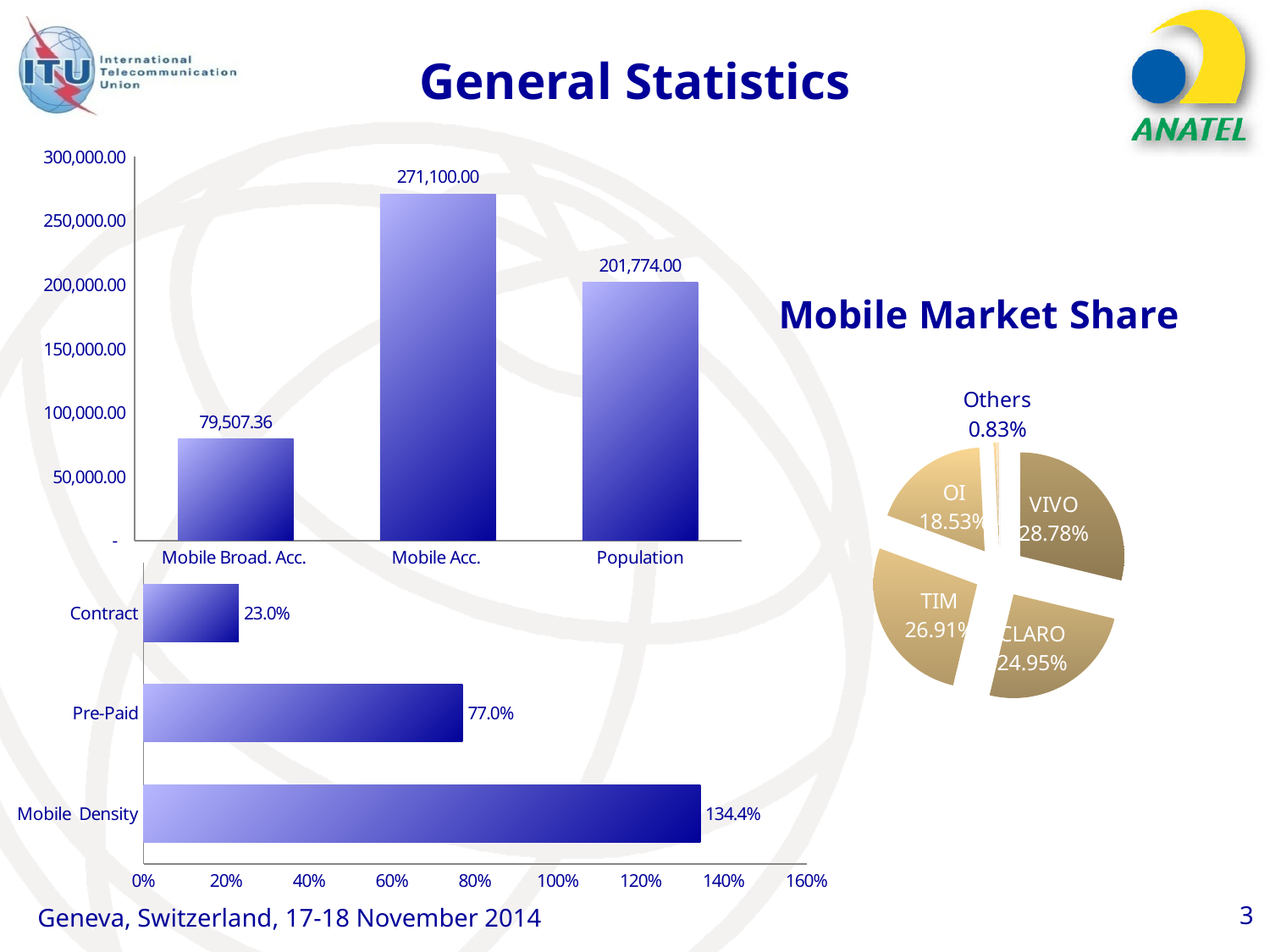
In the bottom-left bar chart, which category has the highest value? Mobile Density In the Mobile Market Share pie chart, what share does TIM have? 26.91% In the top-left bar chart, which category has the lowest value? Mobile Broad. Acc. In the top-left bar chart, what is the value for Population? 201,774.00 In the Mobile Market Share pie chart, which operator has the largest share? VIVO What kind of chart is the bottom-left chart? Bar chart In the bottom-left bar chart, what is the value for Pre-Paid? 77.0% In the top-left bar chart, what is the value for Mobile Acc.? 271,100.00 In the top-left bar chart, how many categories are shown? 3 In the top-left bar chart, what is the difference between Mobile Acc. and Population? 69,326.00 In the bottom-left bar chart, what is the difference between Pre-Paid and Contract? 54.0%